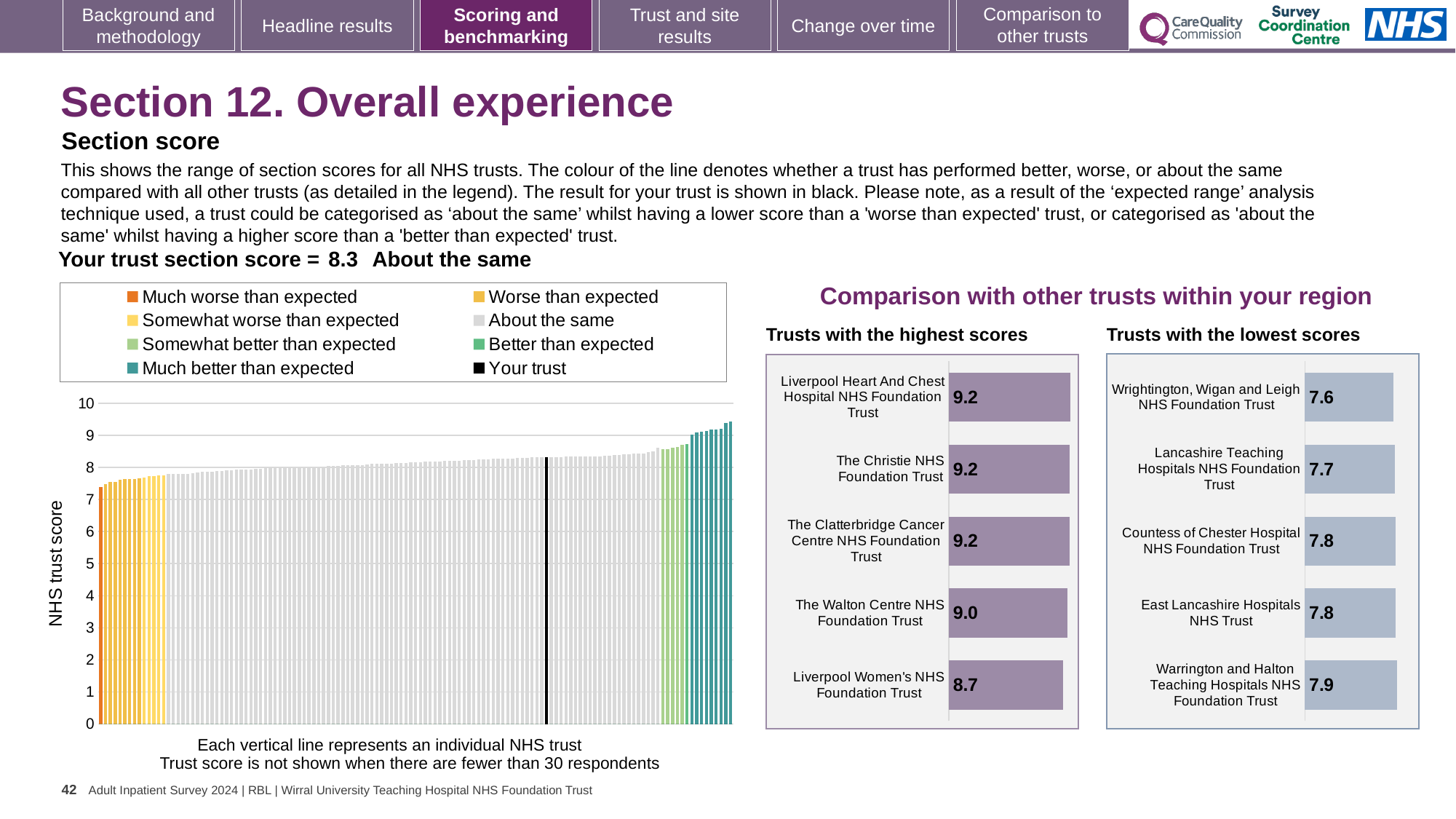
In the large chart on the left, what is the section score for your trust (the black line)? 8.3 In the 'Trusts with the highest scores' chart, which trust has the lowest score? Liverpool Women's NHS Foundation Trust In the 'Trusts with the highest scores' chart, what is the score for The Walton Centre NHS Foundation Trust? 9.0 In the 'Trusts with the lowest scores' chart, what is the difference between the scores of Warrington and Halton Teaching Hospitals NHS Foundation Trust and Wrightington, Wigan and Leigh NHS Foundation Trust? 0.3 How many trusts are shown in the 'Trusts with the lowest scores' chart? 5 In the 'Trusts with the lowest scores' chart, which has the larger score: Countess of Chester Hospital NHS Foundation Trust or Lancashire Teaching Hospitals NHS Foundation Trust? Countess of Chester Hospital NHS Foundation Trust How many trusts are shown in the 'Trusts with the highest scores' chart? 5 What kind of chart is the large chart on the left showing NHS trust scores? Bar chart How many entries does the legend of the large chart on the left list? 8 In the 'Trusts with the highest scores' chart, what is the difference between the scores of Liverpool Heart And Chest Hospital NHS Foundation Trust and Liverpool Women's NHS Foundation Trust? 0.5 In the 'Trusts with the lowest scores' chart, which trust has the highest score? Warrington and Halton Teaching Hospitals NHS Foundation Trust In the 'Trusts with the lowest scores' chart, what is the score for Wrightington, Wigan and Leigh NHS Foundation Trust? 7.6